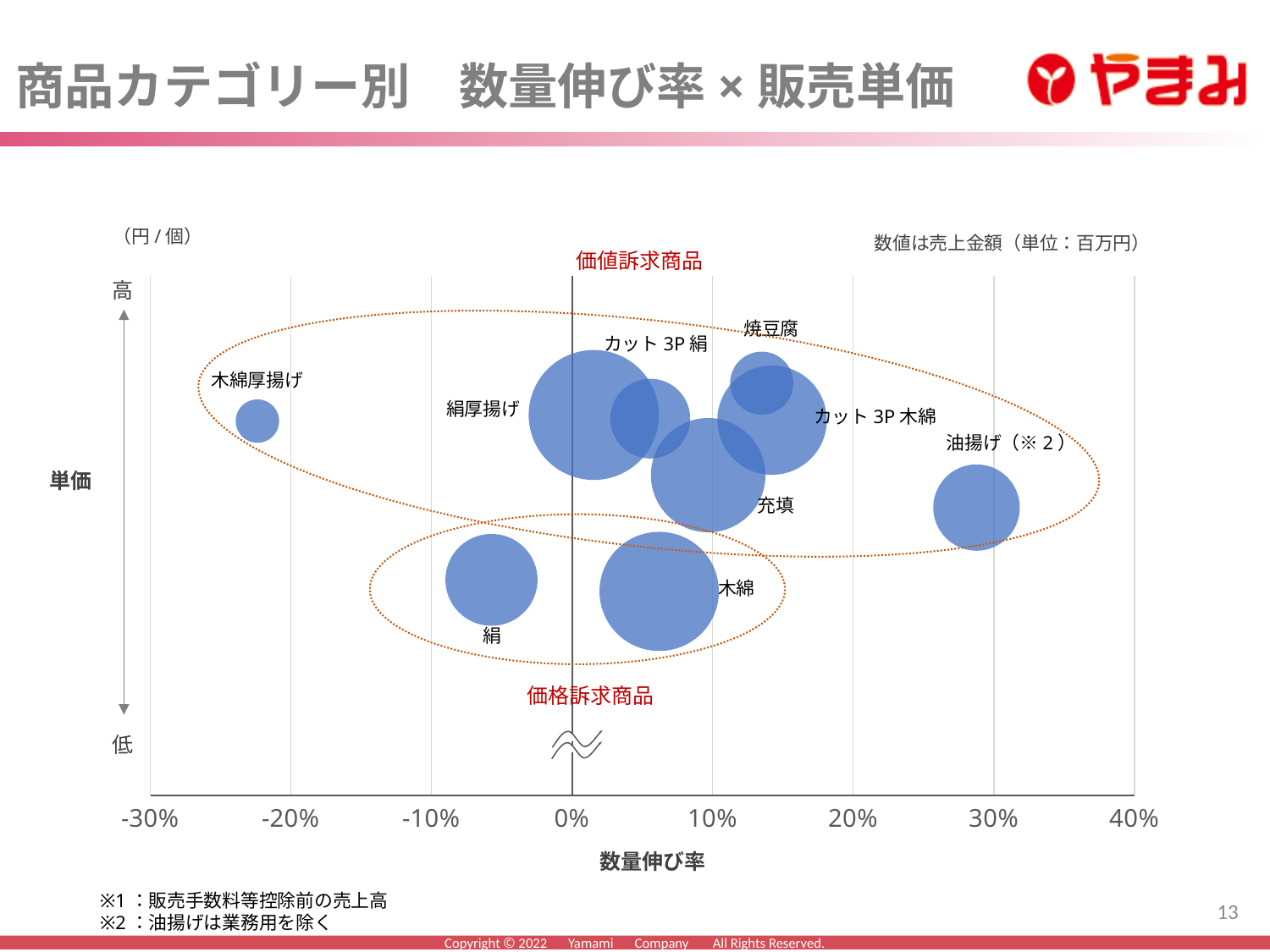
What kind of chart is shown on the slide? bubble chart Which product category has the lowest 数量伸び率 (furthest left on the x axis)? 木綿厚揚げ How many product categories (bubbles) are plotted on the chart? 9 Is the 数量伸び率 for 絹 greater or less than 0%? less What is the label of the horizontal axis of the chart? 数量伸び率 Which has the higher 数量伸び率, 油揚げ（※2） or 木綿厚揚げ? 油揚げ（※2） Which product category is positioned highest on the 単価 (unit price) axis? 焼豆腐 Is the 数量伸び率 for 木綿 greater or less than 0%? greater Is the 数量伸び率 for 油揚げ（※2） greater or less than 20%? greater What does the note at the top right say the bubble values represent? 売上金額（単位：百万円） Which product category has the highest 数量伸び率 (furthest right on the x axis)? 油揚げ（※2）